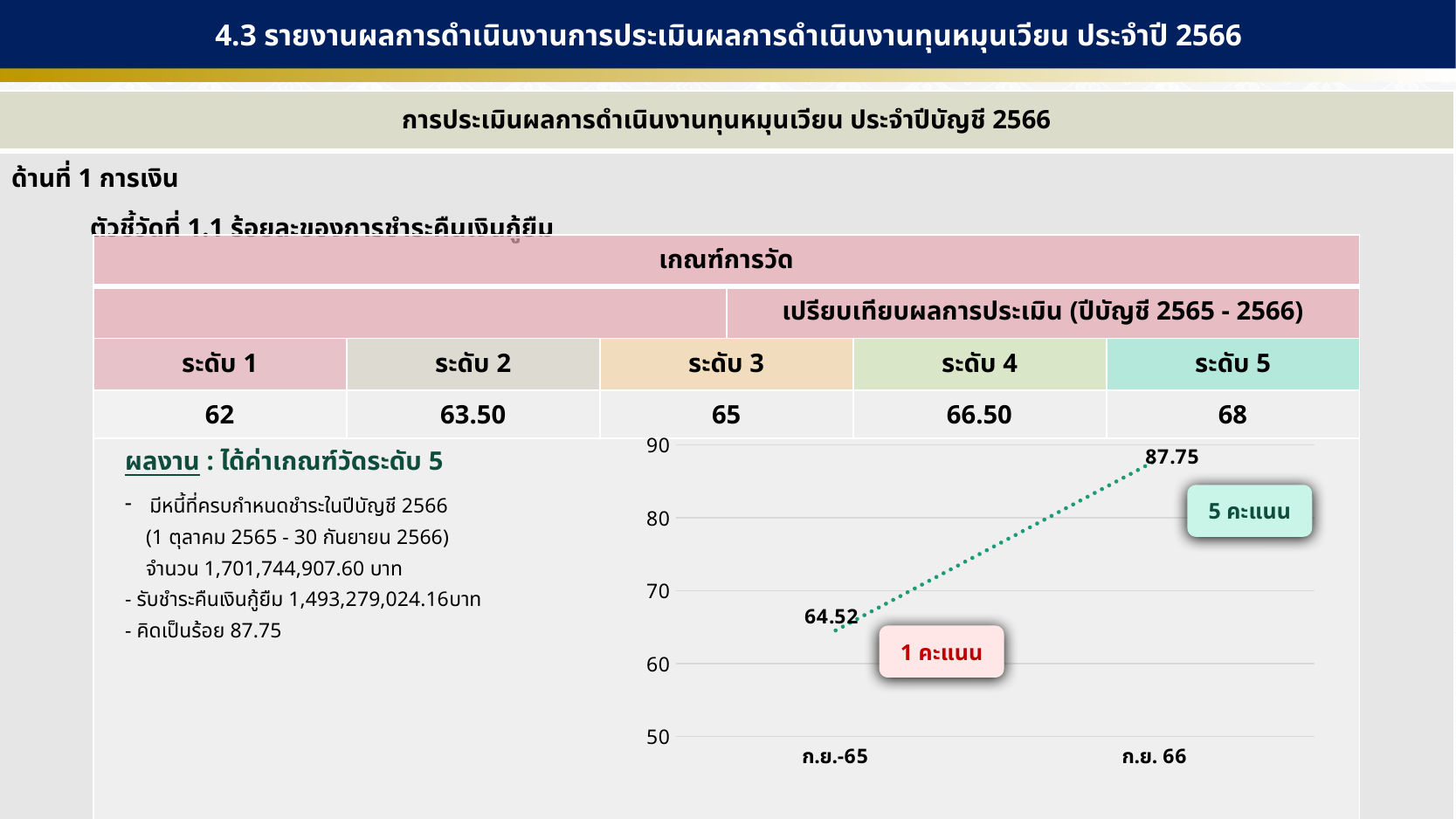
Which category on the chart has the highest value? ก.ย. 66 How many data points are plotted on the chart? 2 What is the value plotted for ก.ย.-65 on the chart? 64.52 Which point on the chart has the higher value, ก.ย.-65 or ก.ย. 66? ก.ย. 66 What is the difference between the values for ก.ย. 66 and ก.ย.-65 on the chart? 23.23 Which category on the chart has the lowest value? ก.ย.-65 Is the value for ก.ย.-65 greater or less than 70? less Is the value for ก.ย. 66 greater or less than 80? greater What is the value plotted for ก.ย. 66 on the chart? 87.75 What score label is shown in the callout next to the ก.ย. 66 point on the chart? 5 คะแนน Do the values on the chart rise or fall from ก.ย.-65 to ก.ย. 66? rise What kind of chart is shown on the slide? line chart